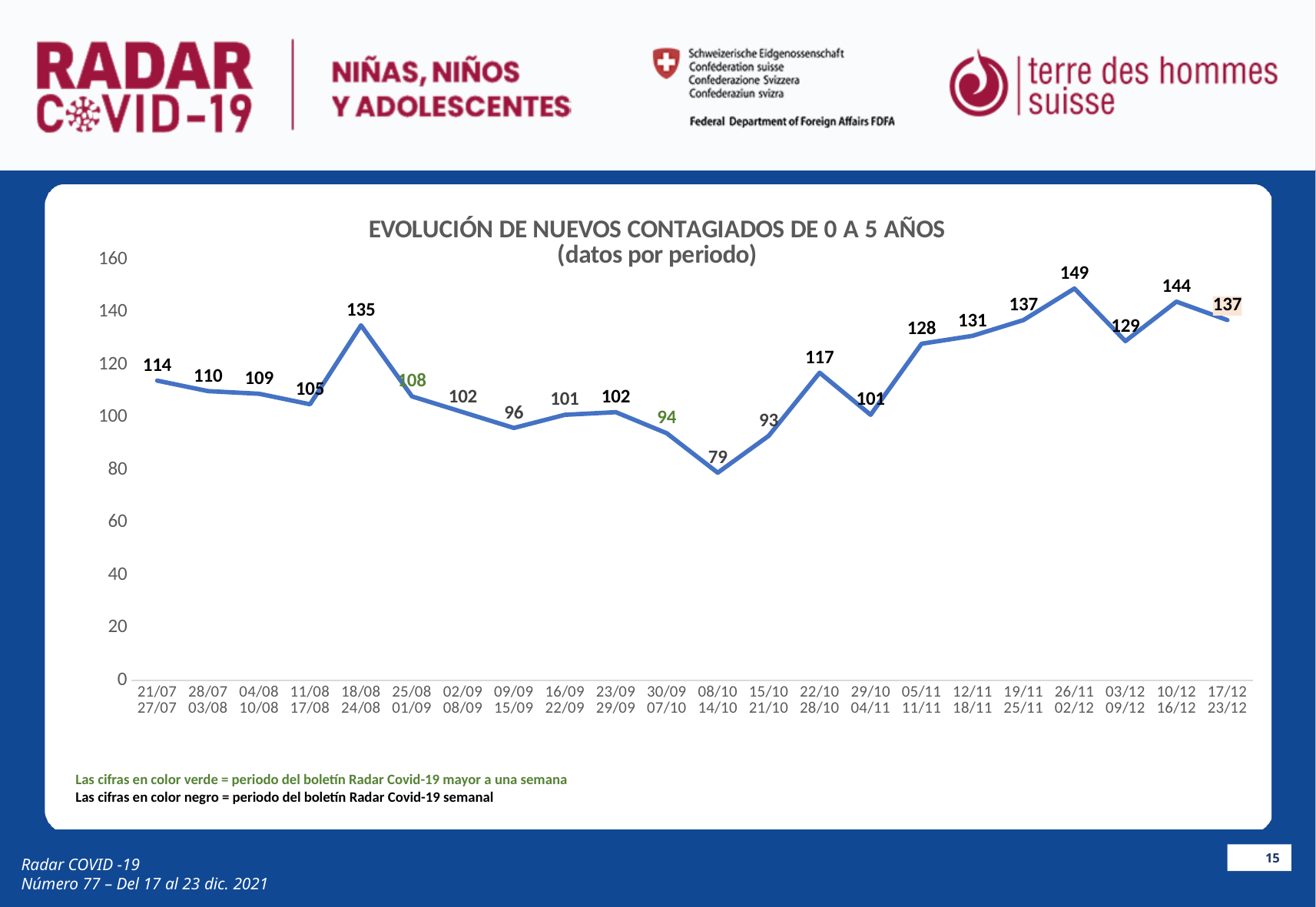
How many periods (data points) are plotted on the chart? 22 What is the value for the period 08/10–14/10? 79 What is the title of the chart? EVOLUCIÓN DE NUEVOS CONTAGIADOS DE 0 A 5 AÑOS (datos por periodo) What is the difference between the value for 21/07–27/07 and the value for 11/08–17/08? 9 Does the value rise or fall from 15/10–21/10 to 22/10–28/10? rise What is the value for the period 18/08–24/08? 135 Which period has the lowest value? 08/10–14/10 What is the value for the last period, 17/12–23/12? 137 Which is larger, the value for 22/10–28/10 or the value for 29/10–04/11? 22/10–28/10 Which period has the highest value? 26/11–02/12 What type of chart is shown on the slide? line chart What is the difference between the value for 26/11–02/12 and the value for 03/12–09/12? 20